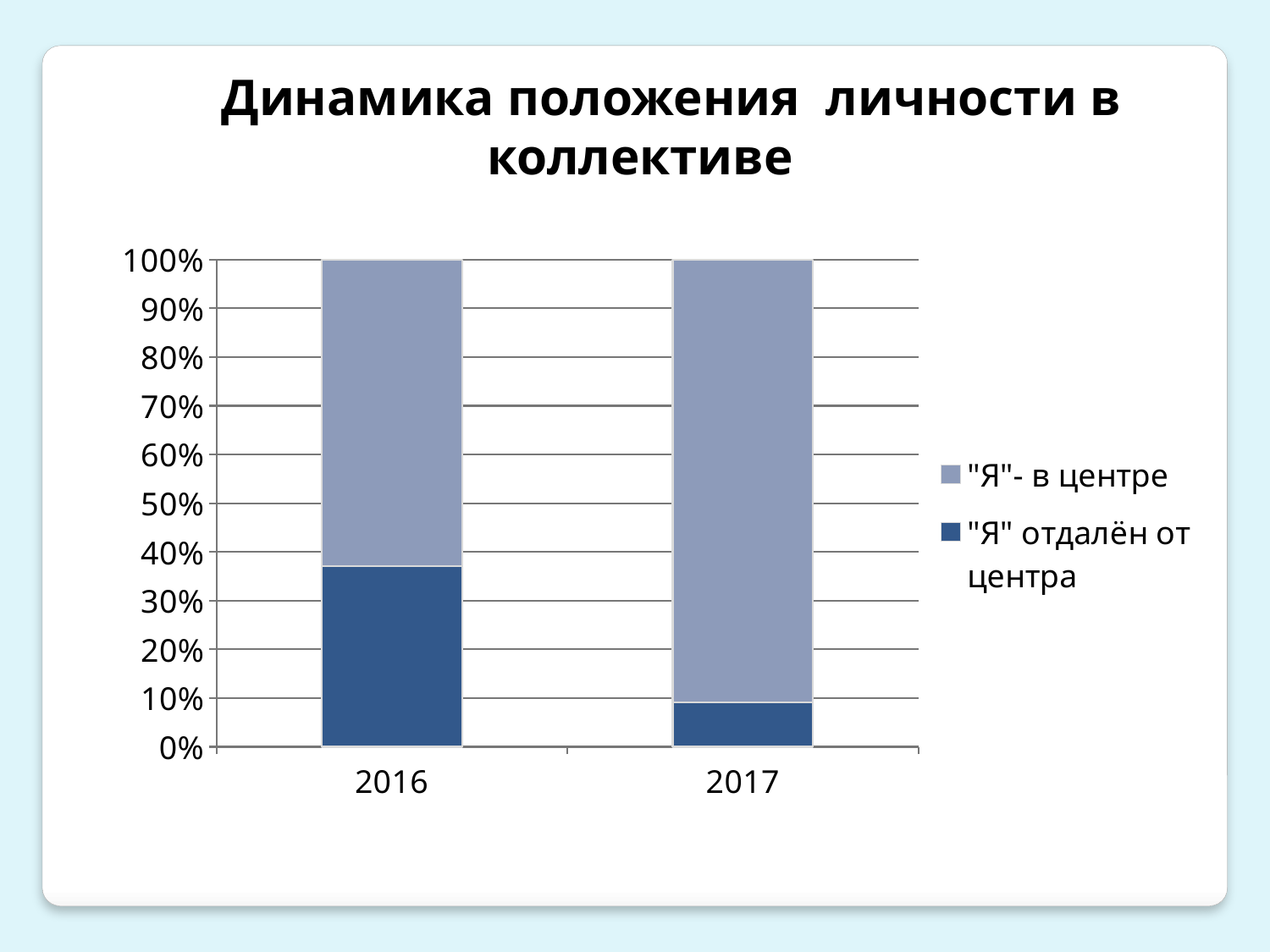
Is the value for "Я" отдалён от центра in 2016 greater or less than 40%? less What is the title of the chart? Динамика положения личности в коллективе Does the share of "Я" отдалён от центра rise or fall from 2016 to 2017? fall Which years are shown on the x axis? 2016 and 2017 How many categories are shown on the x axis? 2 What kind of chart is shown on the slide? Stacked bar chart How many series does the legend list? 2 Which year has the larger share of "Я" отдалён от центра, 2016 or 2017? 2016 Is the value for "Я" отдалён от центра in 2017 greater or less than 20%? less Is the value for "Я"- в центре in 2017 greater or less than 80%? greater